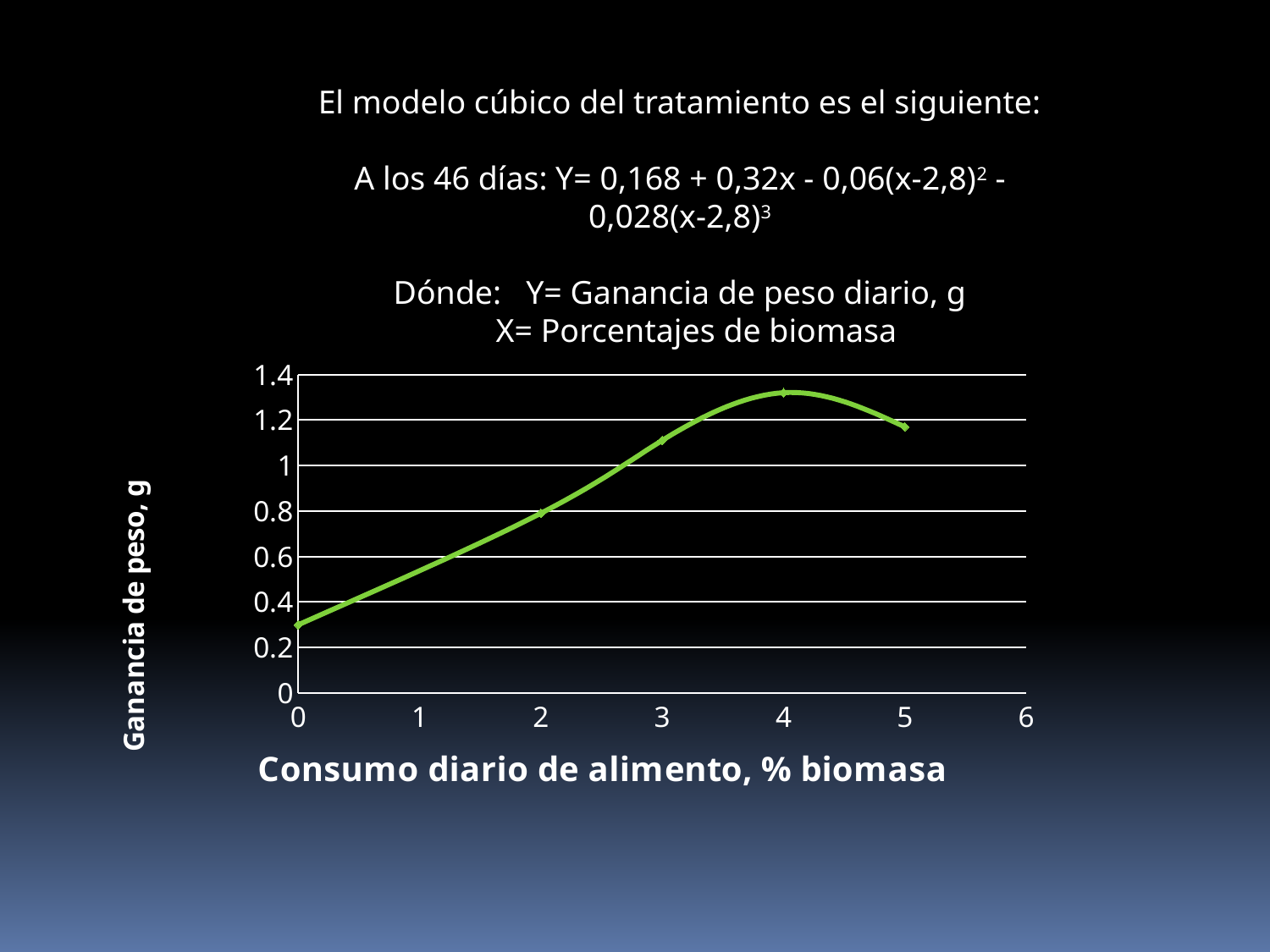
Is the value at x = 5 greater or less than 1? greater How does the line behave as x increases from 0 to 5? rises until x = 4, then falls Is the value at x = 0 greater or less than 0.4? less What is the title of the y axis? Ganancia de peso, g Is the value at x = 4 greater or less than 1.2? greater Which is larger, the value at x = 4 or the value at x = 5? x = 4 What is the title of the x axis? Consumo diario de alimento, % biomasa What kind of chart is shown on the slide? line chart How many data points are plotted on the line? 5 At which x value (Consumo diario de alimento) is the plotted value lowest? 0 At which x value (Consumo diario de alimento) does the line reach its highest point? 4